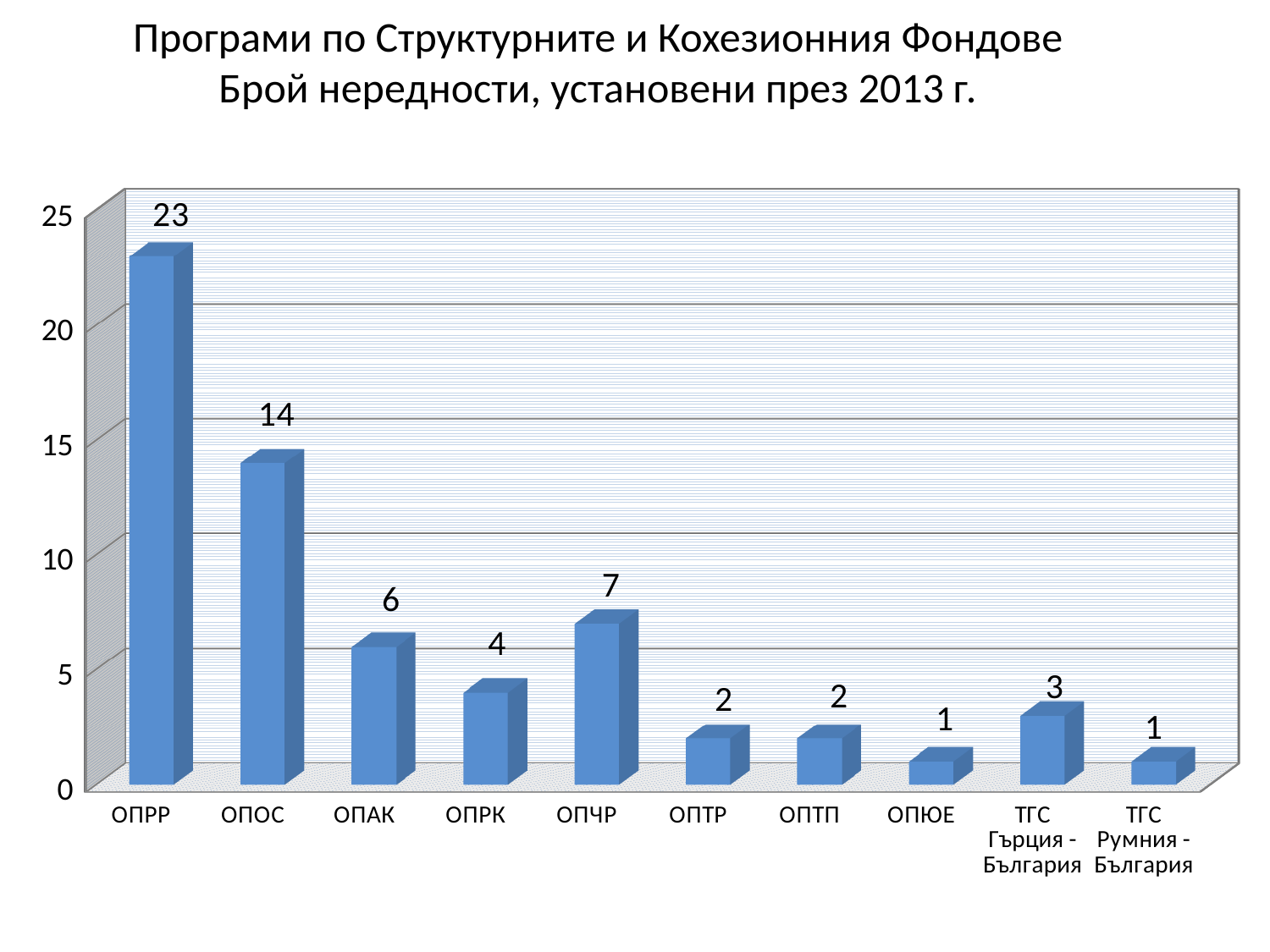
What is the difference between the values for ОПАК and ОПРК? 2 What is the difference between the values for ОПРР and ОПОС? 9 What is the second line of the chart title? Брой нередности, установени през 2013 г. How many categories are shown on the x axis? 10 What kind of chart is shown on the slide? bar chart Is the value for ОПОС greater or less than 10? greater What is the value for ОПЧР? 7 What is the value for ОПРР? 23 What is the value for ОПЮЕ? 1 Which category has the highest value? ОПРР What is the value for ТГС Гърция - България? 3 Which is larger, the value for ОПАК or the value for ОПЧР? ОПЧР